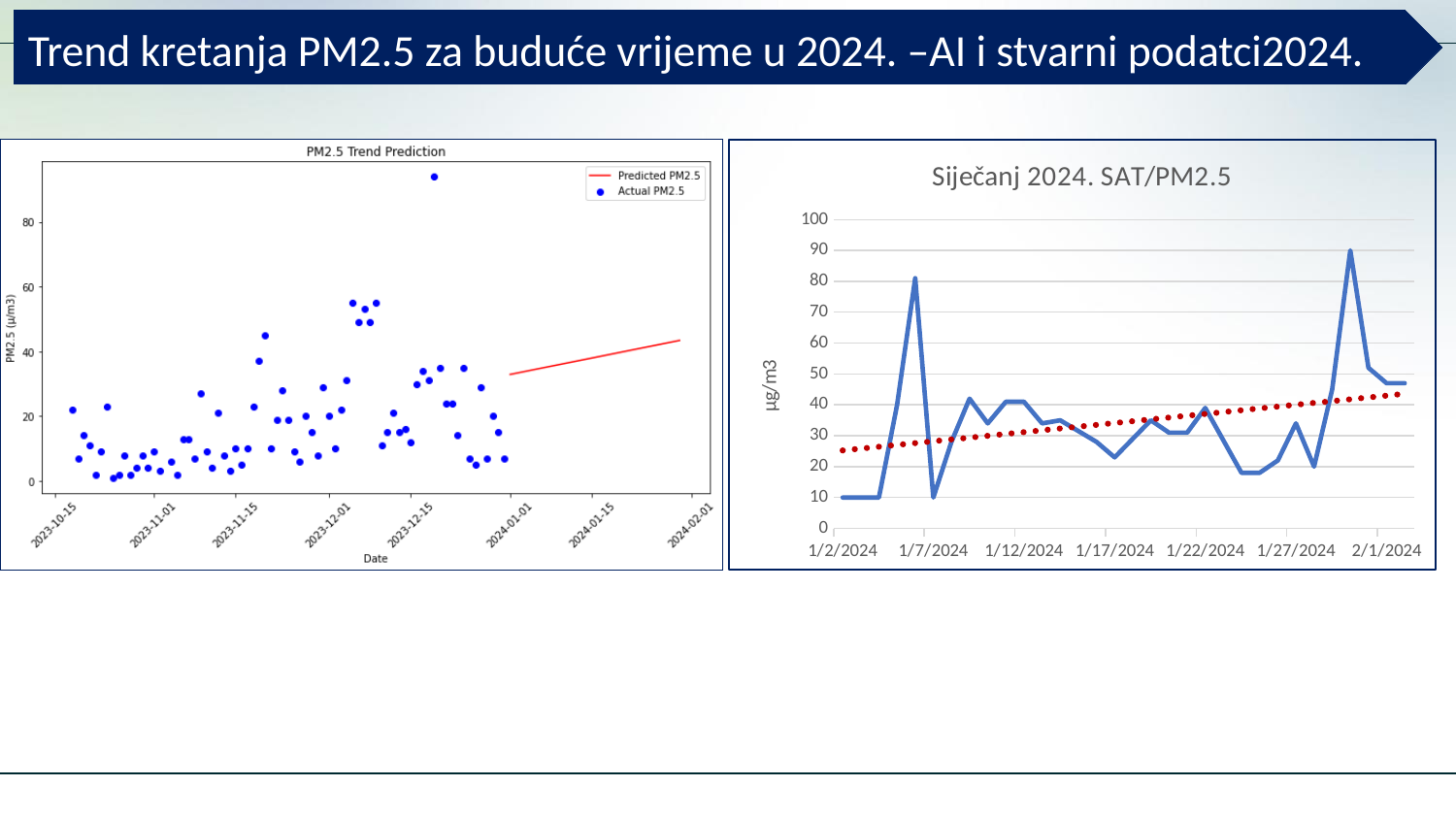
In the right chart 'Siječanj 2024. SAT/PM2.5', is the value on 2/1/2024 greater or less than 40? greater In the right chart 'Siječanj 2024. SAT/PM2.5', does the dotted red trend line rise or fall from left to right? rise In the left chart 'PM2.5 Trend Prediction', what is the label of the x axis? Date What type of chart is the right chart titled 'Siječanj 2024. SAT/PM2.5'? line chart In the left chart 'PM2.5 Trend Prediction', how many series does the legend list? 2 In the right chart 'Siječanj 2024. SAT/PM2.5', is the peak value near 1/7/2024 greater or less than 70? greater In the left chart 'PM2.5 Trend Prediction', does the red Predicted PM2.5 line rise or fall from left to right? rise In the right chart 'Siječanj 2024. SAT/PM2.5', which is higher: the peak near 1/7/2024 or the peak near the end of January? the peak near the end of January In the left chart 'PM2.5 Trend Prediction', is the highest Actual PM2.5 point greater or less than 80? greater What type of chart is the left chart titled 'PM2.5 Trend Prediction'? scatter chart with a line In the left chart 'PM2.5 Trend Prediction', what are the two legend entries? Predicted PM2.5 and Actual PM2.5